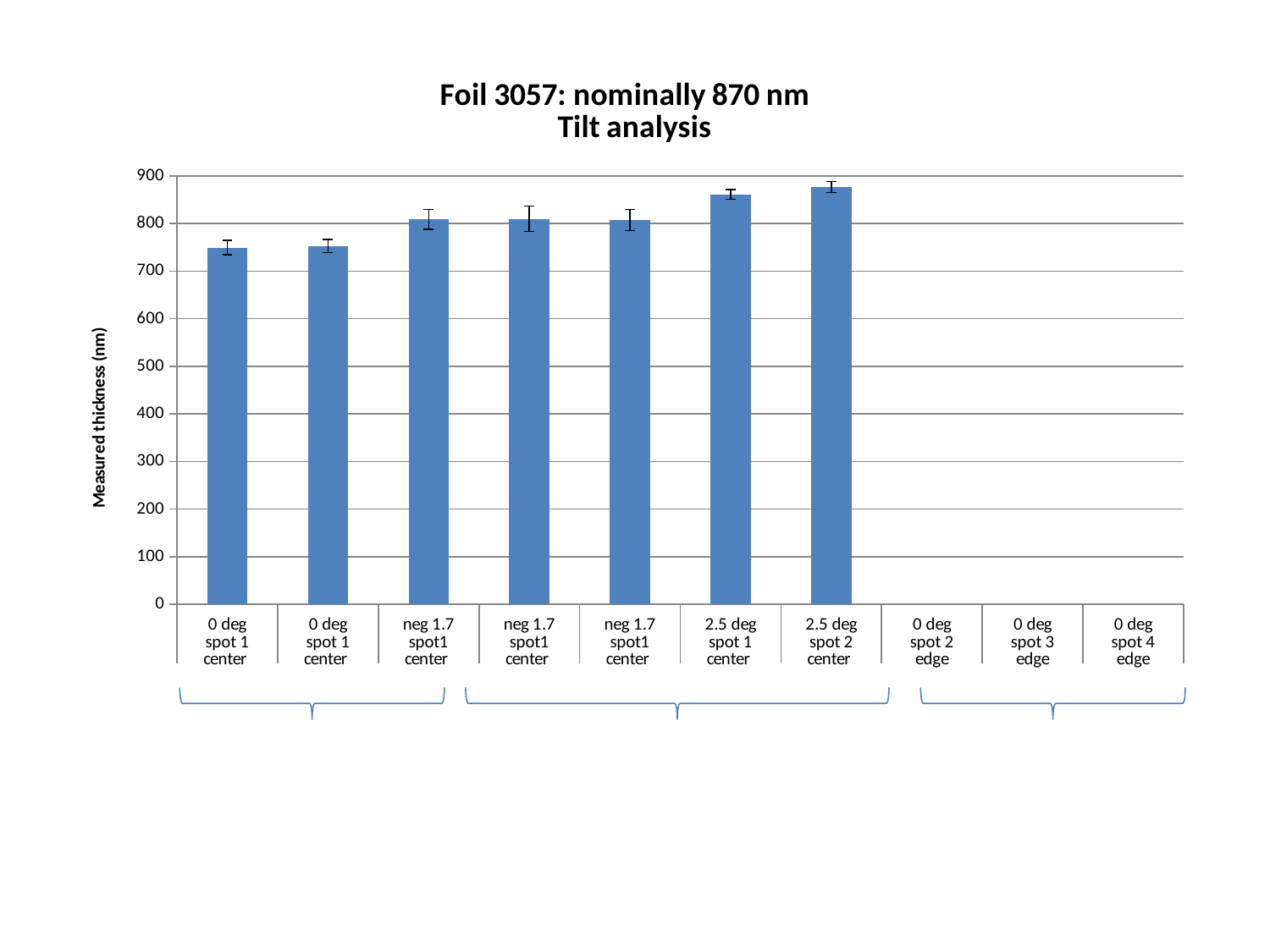
How many categories are listed along the x axis? 10 Is the value for '2.5 deg spot 1 center' greater or less than 800? greater What is the label of the vertical axis? Measured thickness (nm) Which category has the tallest bar? 2.5 deg spot 2 center Is the value for '2.5 deg spot 2 center' greater or less than 900? less What kind of chart is shown on the slide? bar chart Is the value for the first '0 deg spot 1 center' bar greater or less than 800? less Which is larger, the value for '2.5 deg spot 1 center' or the first '0 deg spot 1 center' bar? 2.5 deg spot 1 center What is the title of the chart? Foil 3057: nominally 870 nm Tilt analysis Which is larger, the value for '2.5 deg spot 2 center' or the second 'neg 1.7 spot1 center' bar? 2.5 deg spot 2 center